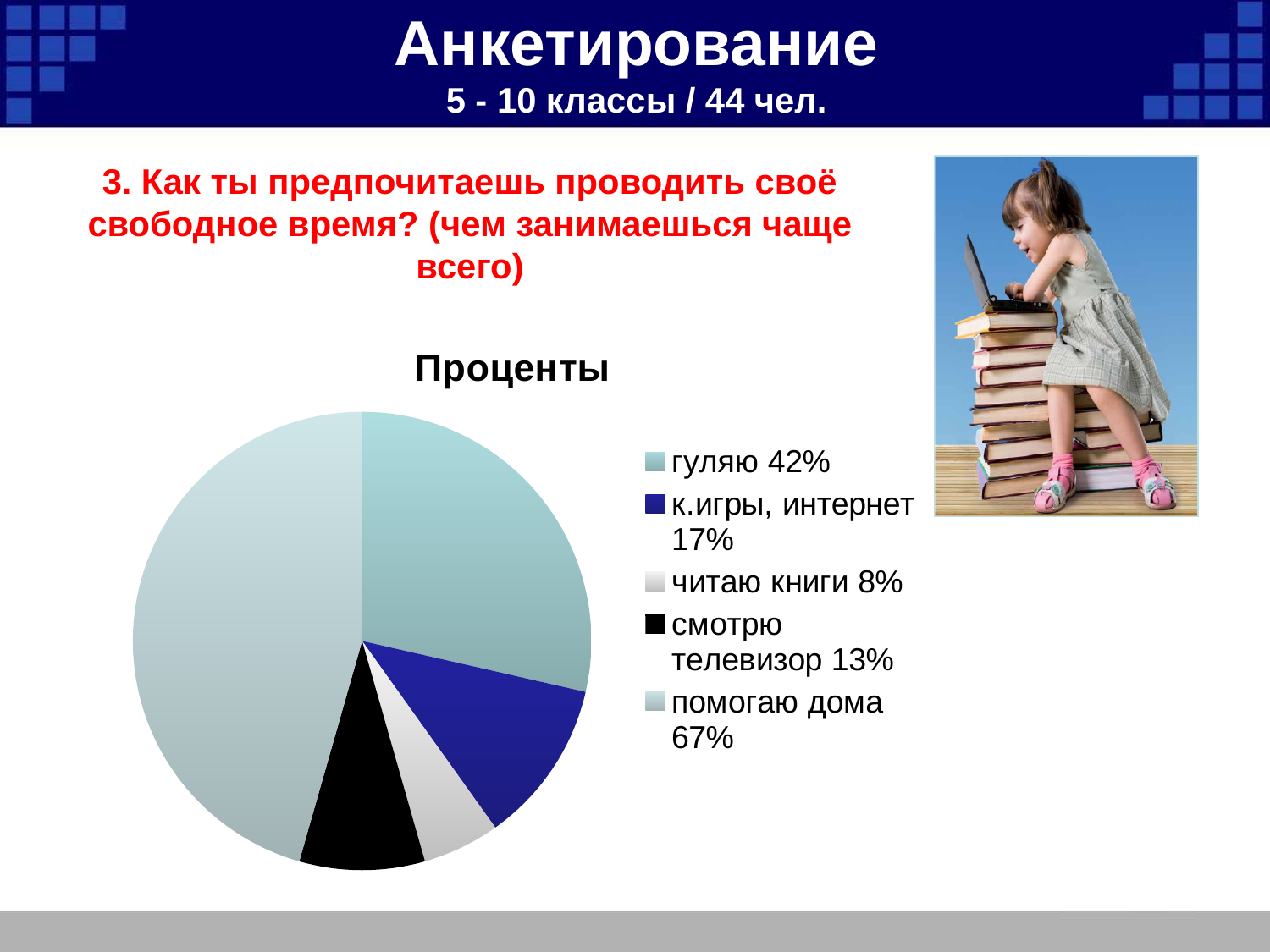
What percentage is shown for "к.игры, интернет"? 17% Which category has the lowest percentage? читаю книги Which is larger, the percentage for "гуляю" or for "смотрю телевизор"? гуляю Which category has the highest percentage? помогаю дома What percentage is shown for "читаю книги"? 8% How many categories does the pie chart have? 5 What is the difference between the percentages for "помогаю дома" and "гуляю"? 25% What percentage is shown for "гуляю"? 42% What is the title of the chart? Проценты What kind of chart is shown on the slide? pie chart What percentage is shown for "смотрю телевизор"? 13% What percentage is shown for "помогаю дома"? 67%